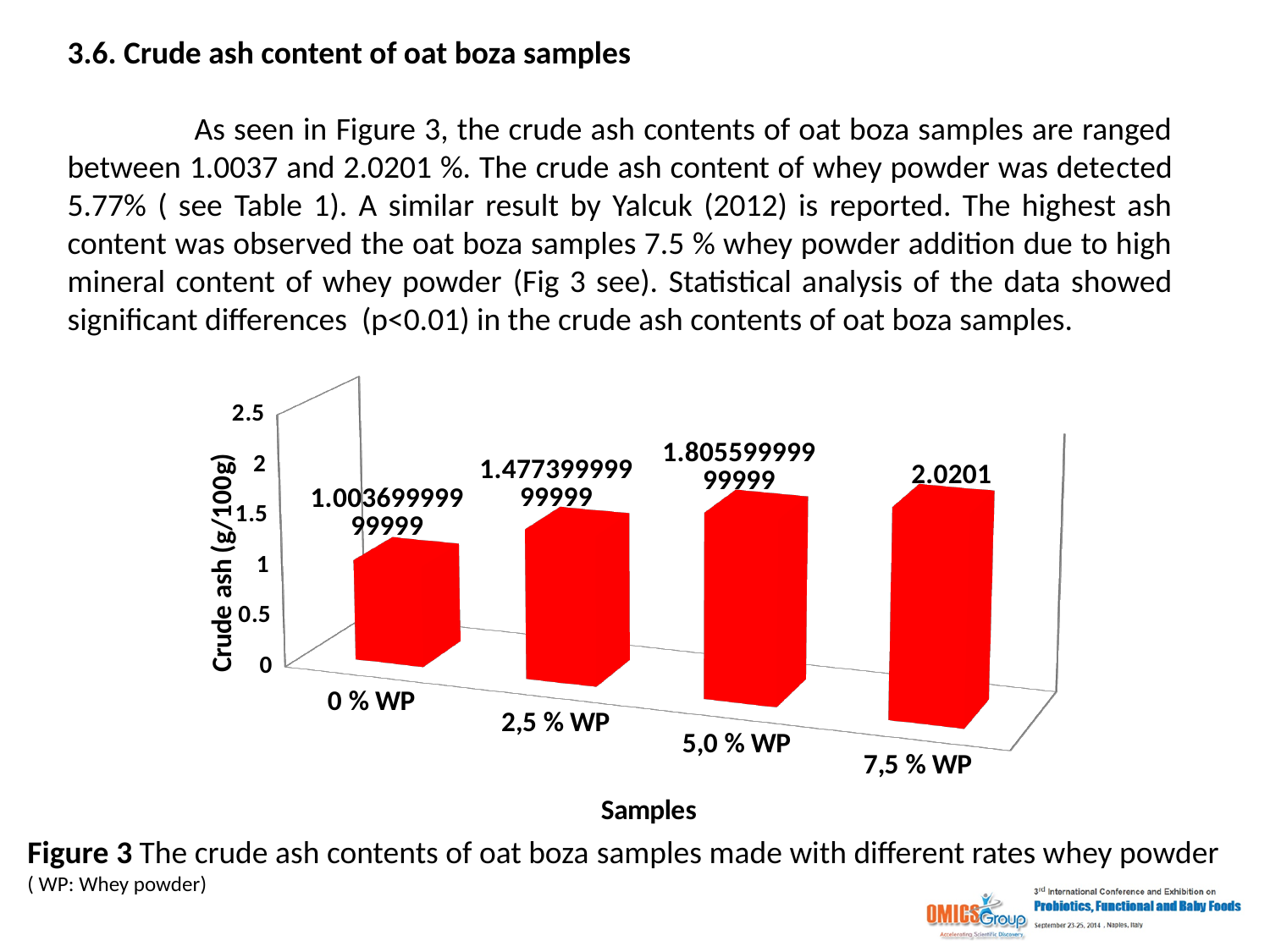
What is the label of the vertical axis of the chart? Crude ash (g/100g) What is the data label shown on the bar for 5,0 % WP? 1.80559999999999 Which sample has the highest crude ash content? 7,5 % WP What is the data label shown on the bar for 2,5 % WP? 1.47739999999999 What is the crude ash value shown for the 7,5 % WP sample? 2.0201 How many samples are plotted in the chart? 4 Which has a higher crude ash value, 2,5 % WP or 5,0 % WP? 5,0 % WP Do the crude ash values rise or fall as the whey powder rate increases along the x axis? rise Is the crude ash value for 0 % WP greater or less than 1.5? less Which sample has the lowest crude ash content? 0 % WP What kind of chart is used to show the crude ash contents? bar chart What is the data label shown on the bar for 0 % WP? 1.00369999999999